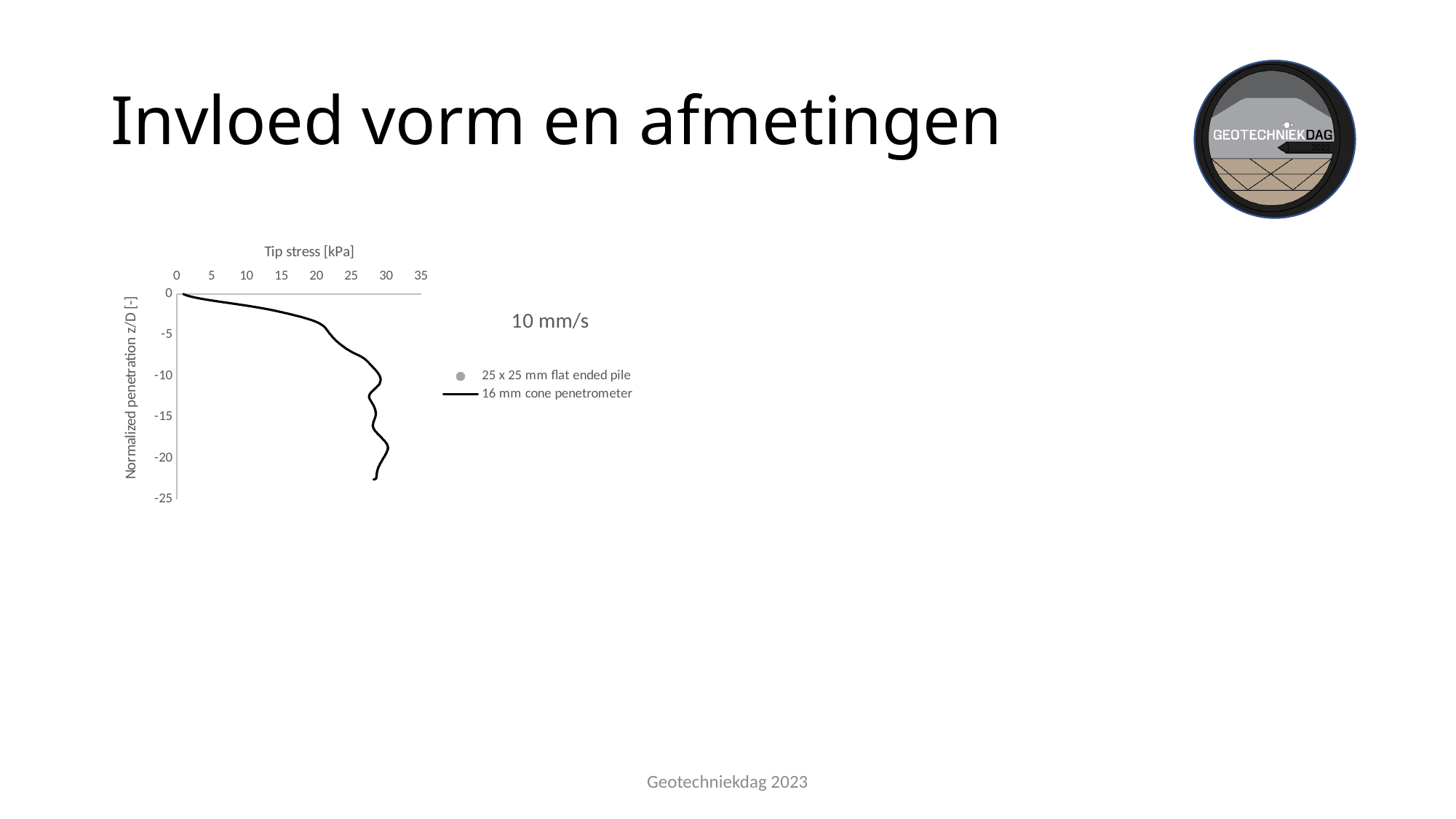
Is the tip stress of the 16 mm cone penetrometer at a normalized penetration of -20 greater or less than 25 kPa? greater Is the tip stress of the 16 mm cone penetrometer at a normalized penetration of -10 greater or less than 25 kPa? greater What is the title of the vertical axis of the chart? Normalized penetration z/D [-] Does the tip stress of the 16 mm cone penetrometer rise or fall as the normalized penetration goes from 0 to -10? rise What penetration speed is stated next to the chart? 10 mm/s Which series is drawn as a black line in the chart? 16 mm cone penetrometer What kind of chart is shown on the slide? line chart What is the lowest value shown on the vertical axis of the chart? -25 Is the tip stress of the 16 mm cone penetrometer at a normalized penetration of -1 greater or less than 15 kPa? less What is the title of the horizontal axis of the chart? Tip stress [kPa] What is the largest value shown on the horizontal axis of the chart? 35 How many series does the chart legend list? 2